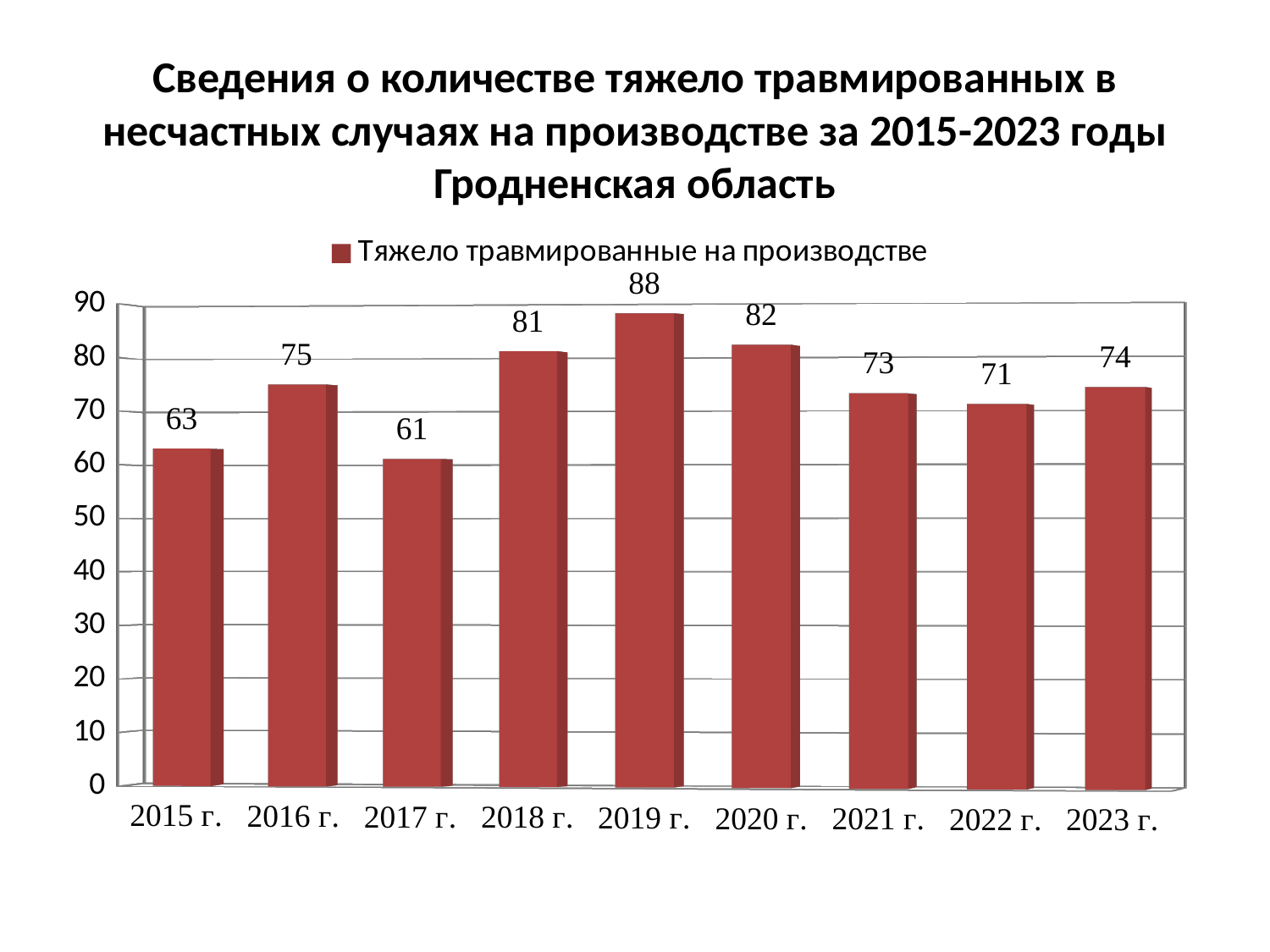
What is the value for 2019 г.? 88 Which is larger, the value for 2020 г. or the value for 2021 г.? 2020 г. What is the value for 2015 г.? 63 Which year has the lowest value? 2017 г. What is the legend entry for the series shown? Тяжело травмированные на производстве What is the difference between the values for 2019 г. and 2017 г.? 27 What is the difference between the values for 2018 г. and 2016 г.? 6 Is the value for 2018 г. greater or less than 80? greater How many years are shown on the x axis? 9 Which year has the highest value? 2019 г. What is the value for 2022 г.? 71 What kind of chart is shown on the slide? bar chart